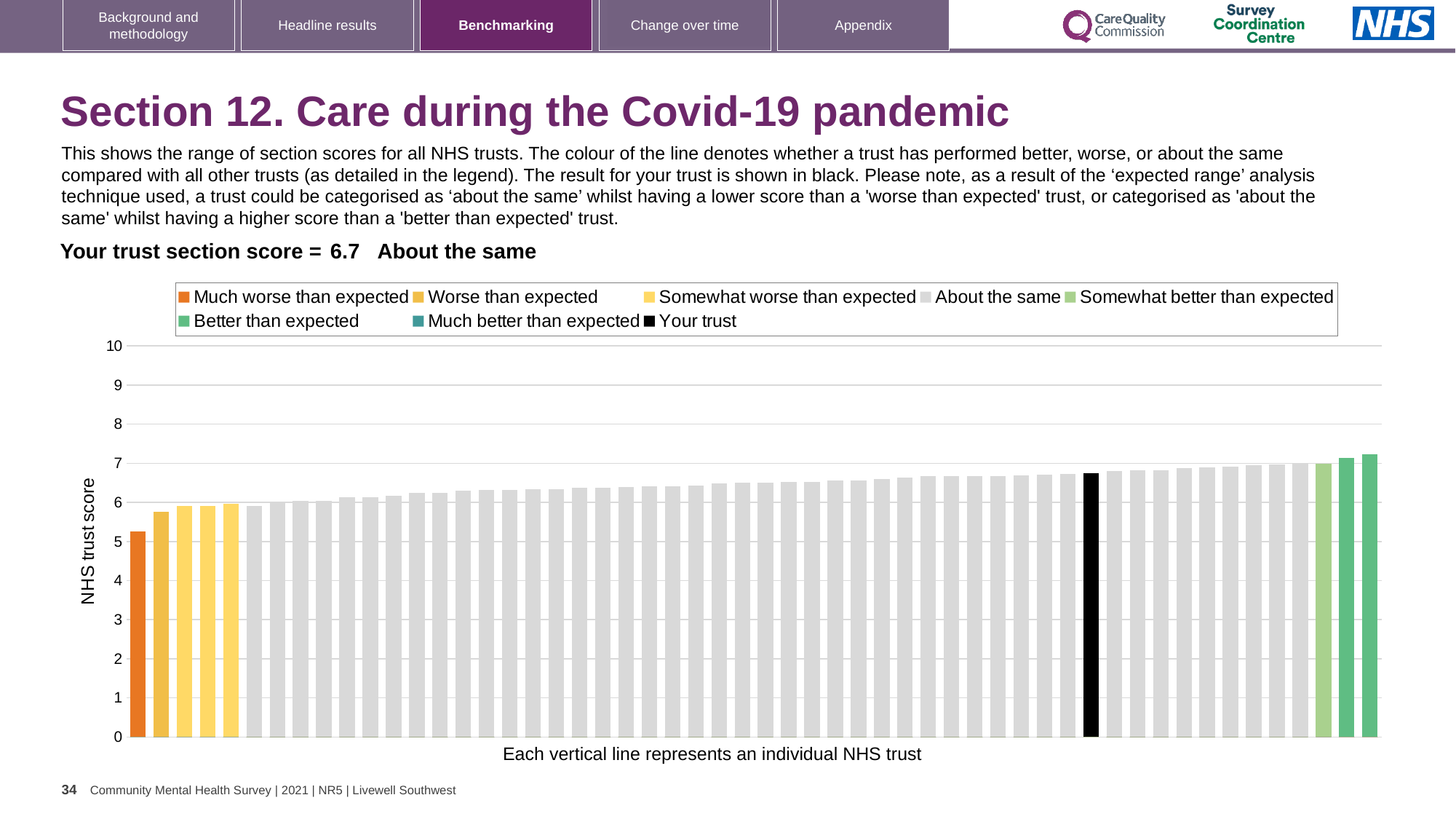
Which benchmarking category is your trust placed in for this section? About the same What kind of chart is shown on the slide? bar chart What is the maximum value shown on the vertical axis? 10 What is the section score for your trust? 6.7 Is the value for your trust (black bar) greater or less than 6? greater How many bars are coloured orange (Much worse than expected)? 1 Is the value for the highest-scoring trust greater or less than 8? less How many entries does the chart legend list? 8 Is your trust's score higher or lower than the lowest-scoring trust's score? higher What is the title of the vertical axis? NHS trust score Do the bar values rise or fall from left to right along the x axis? rise Is the value for the lowest-scoring trust (orange bar) greater or less than 6? less